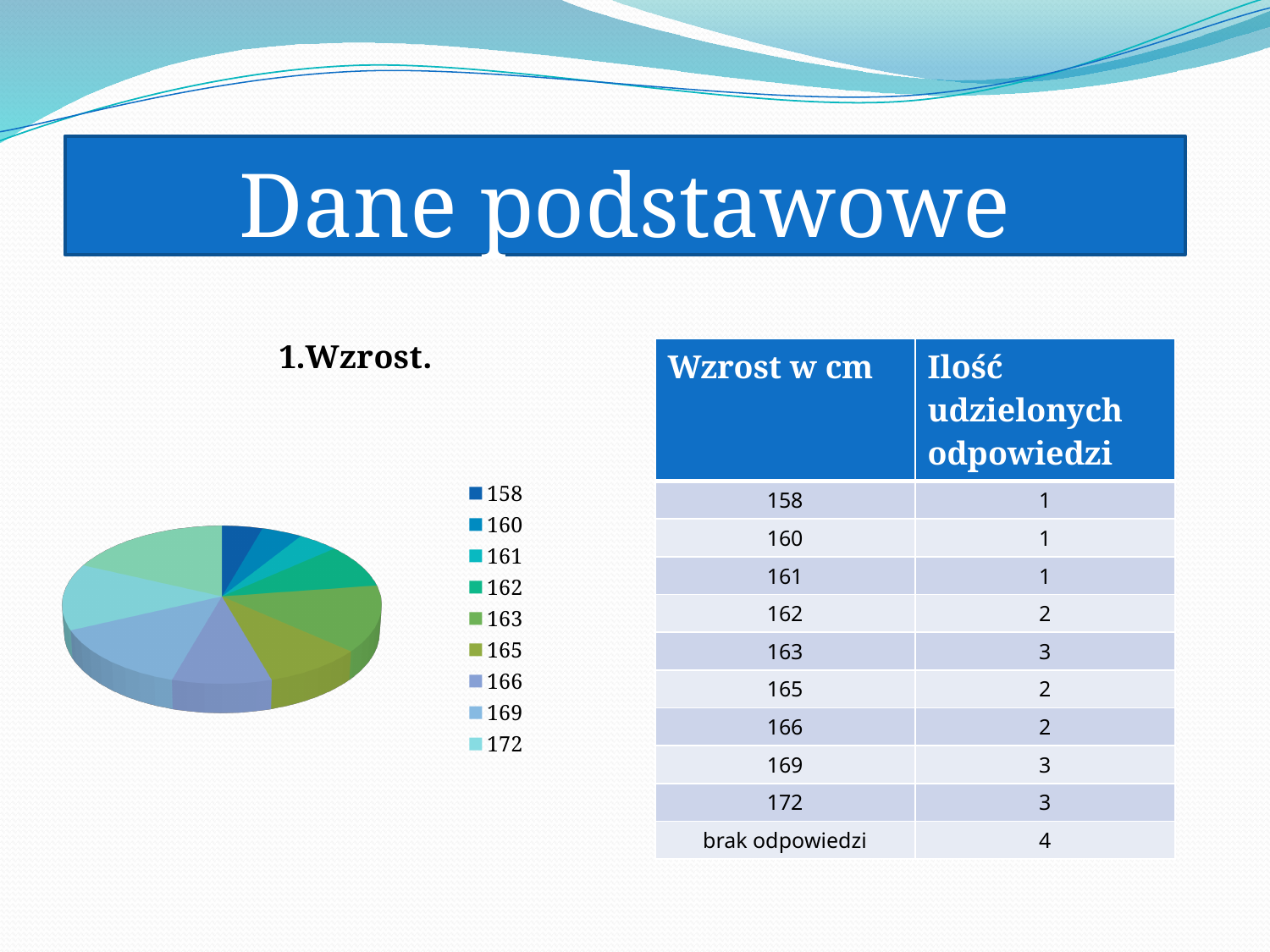
What kind of chart is shown under the heading "1.Wzrost."? pie chart What is the title shown above the pie chart? 1.Wzrost. What is the first entry in the pie chart's legend? 158 How many categories does the legend of the pie chart list? 9 In the pie chart, which slice is larger: 160 or 172? 172 In the pie chart, which slice is larger: 161 or 169? 169 In the pie chart, which slice is larger: 158 or 163? 163